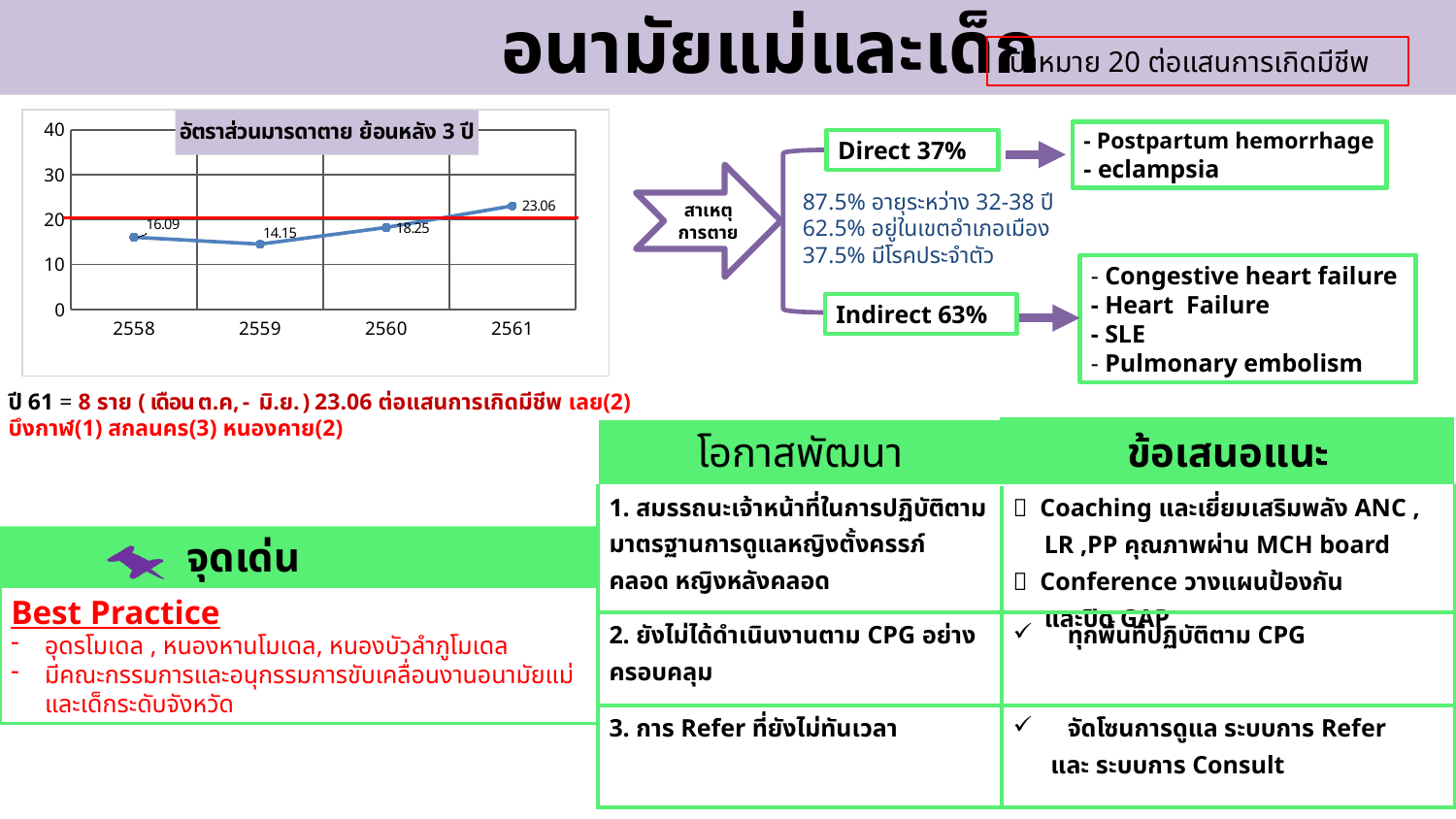
How many years are plotted on the x axis of the chart titled อัตราส่วนมารดาตาย ย้อนหลัง 3 ปี? 4 In the chart titled อัตราส่วนมารดาตาย ย้อนหลัง 3 ปี, do the values rise or fall from 2559 to 2561? rise What kind of chart is the chart titled อัตราส่วนมารดาตาย ย้อนหลัง 3 ปี? line chart What is the value for 2560 in the chart titled อัตราส่วนมารดาตาย ย้อนหลัง 3 ปี? 18.25 Which year has the lowest value in the chart titled อัตราส่วนมารดาตาย ย้อนหลัง 3 ปี? 2559 What is the value for 2561 in the chart titled อัตราส่วนมารดาตาย ย้อนหลัง 3 ปี? 23.06 What is the value for 2558 in the chart titled อัตราส่วนมารดาตาย ย้อนหลัง 3 ปี? 16.09 In the chart titled อัตราส่วนมารดาตาย ย้อนหลัง 3 ปี, which is larger, the value for 2558 or the value for 2559? 2558 In the chart titled อัตราส่วนมารดาตาย ย้อนหลัง 3 ปี, is the value for 2561 greater or less than 20? greater What is the value for 2559 in the chart titled อัตราส่วนมารดาตาย ย้อนหลัง 3 ปี? 14.15 Which year has the highest value in the chart titled อัตราส่วนมารดาตาย ย้อนหลัง 3 ปี? 2561 In the chart titled อัตราส่วนมารดาตาย ย้อนหลัง 3 ปี, what is the difference between the values for 2561 and 2560? 4.81